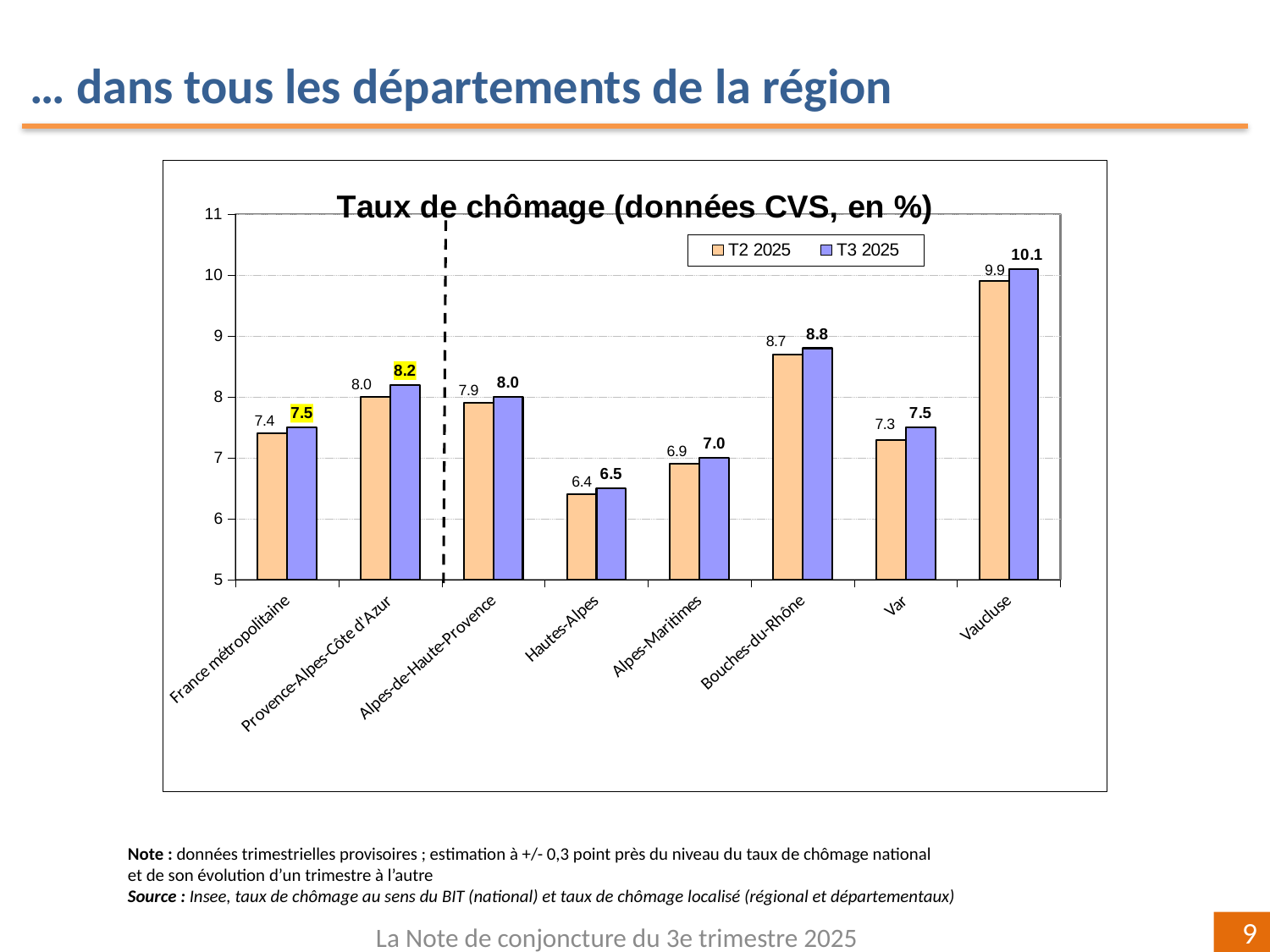
Which category has the highest T3 2025 value? Vaucluse What is the difference between the T3 2025 values for Vaucluse and Bouches-du-Rhône? 1.3 Is the T2 2025 value for Bouches-du-Rhône greater or less than 8? greater What is the difference between the T3 2025 and T2 2025 values for Var? 0.2 What is the T2 2025 value for Hautes-Alpes? 6.4 Which category has the lowest T2 2025 value? Hautes-Alpes What is the T3 2025 value for Provence-Alpes-Côte d'Azur? 8.2 How many categories are shown on the x axis? 8 What is the T3 2025 value for Vaucluse? 10.1 How many series does the legend list? 2 Which is larger, the T3 2025 value for Alpes-Maritimes or the T3 2025 value for Alpes-de-Haute-Provence? Alpes-de-Haute-Provence What kind of chart is shown on the slide? bar chart